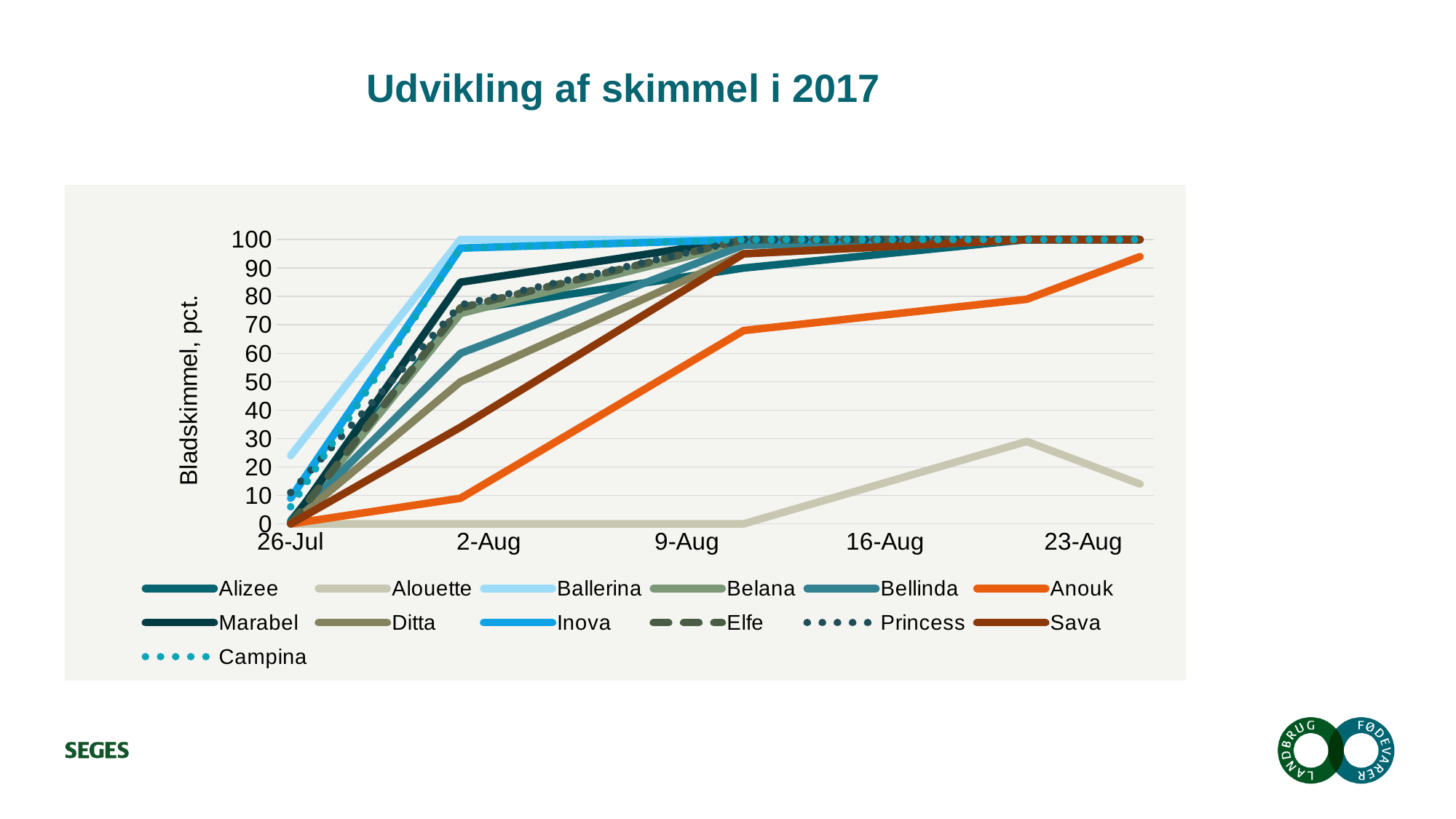
What is the label of the y axis? Bladskimmel, pct. Does the Anouk line rise or fall from 26-Jul to 23-Aug? rise How many dates are labelled on the x axis? 5 What kind of chart is shown on the slide? line chart Is the value for Anouk at 2-Aug greater or less than 20? less What is the title of the chart? Udvikling af skimmel i 2017 At 16-Aug, which is larger: Anouk or Alouette? Anouk Is the value for Alouette at 23-Aug greater or less than 50? less How many series does the legend list? 13 Which series has the highest value at 26-Jul? Ballerina Which series has the lowest value at 23-Aug? Alouette Is the value for Anouk at 16-Aug greater or less than 50? greater